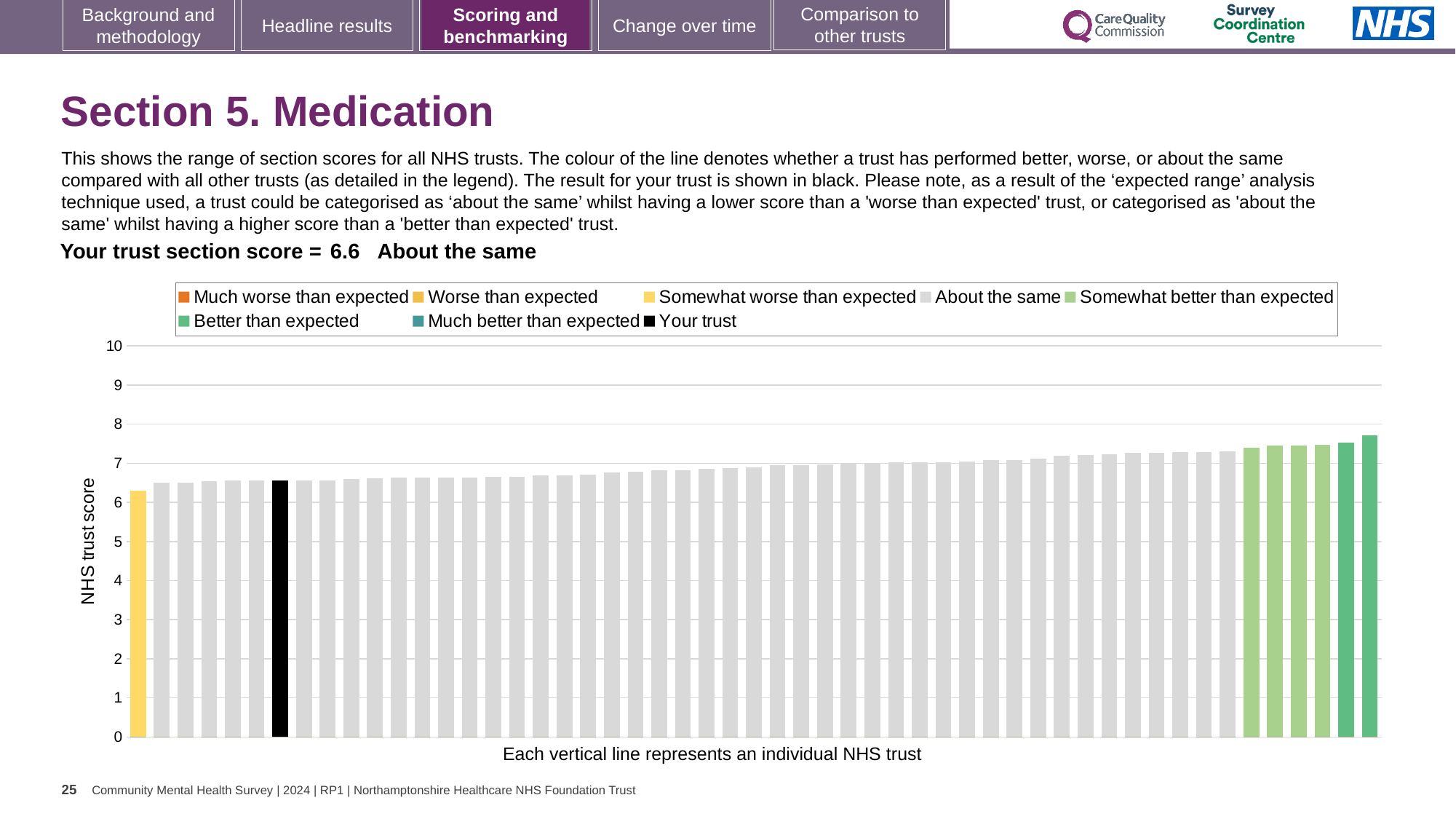
Is the value of the highest bar greater or less than 8? less How is your trust's section score categorised on the slide? About the same What is the label on the vertical axis of the chart? NHS trust score Is the value of the highest bar greater or less than 7? greater What kind of chart is shown on the slide? bar chart What is the section score for your trust shown on the slide? 6.6 Is the value of the lowest bar greater or less than 6? greater How many entries does the chart legend list? 8 Do the bar values rise or fall from left to right along the x axis? rise